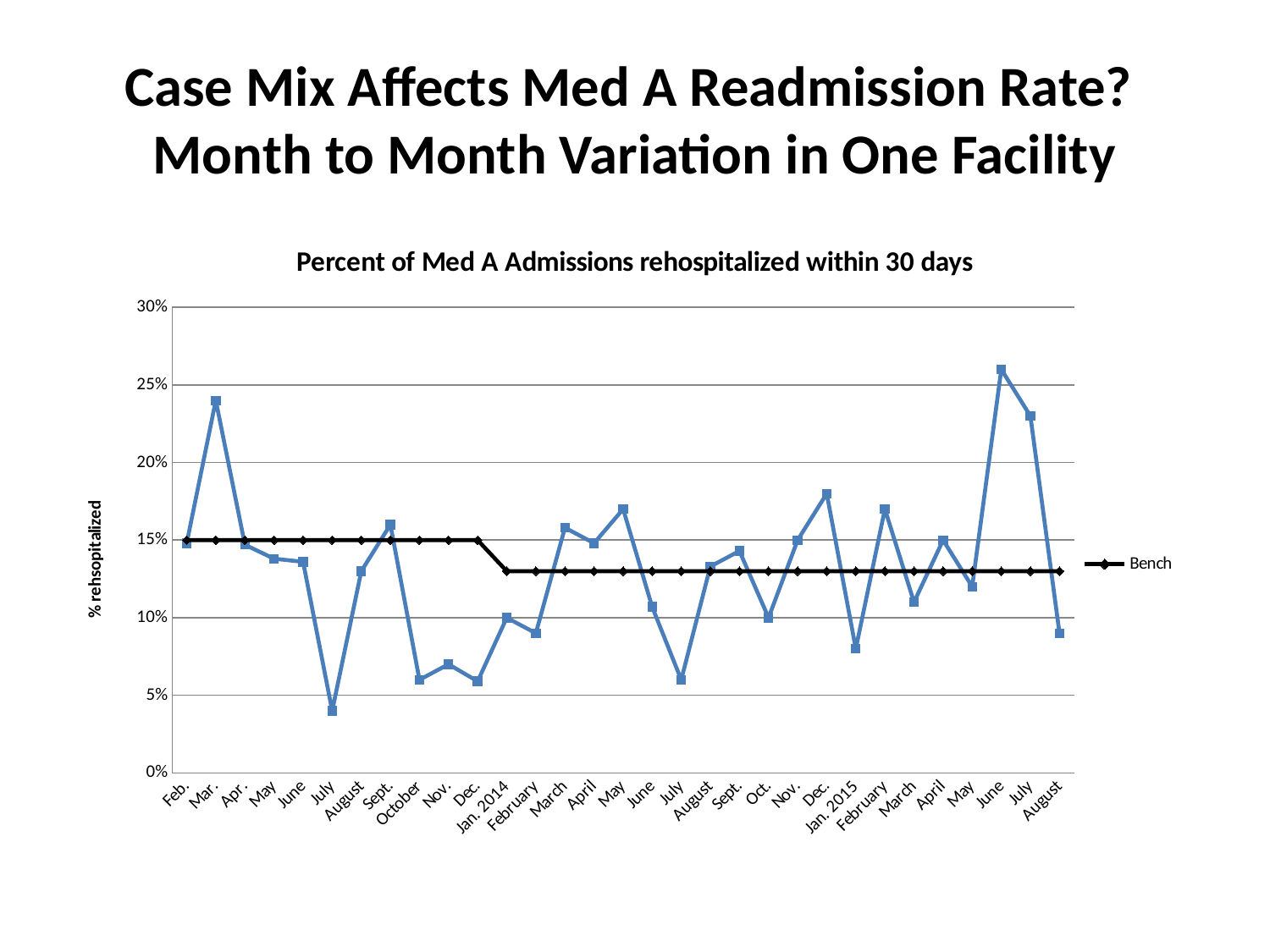
Which has the higher rehospitalization rate, Mar. (2013) or Dec. (2014)? Mar. (2013) What is the value of the Bench line for Feb. (the first month)? 15% Which month has the highest rehospitalization rate? June (2015) Does the Bench line rise or fall from Dec. 2013 to Jan. 2014? fall What kind of chart is shown on the slide? line chart What is the label on the vertical axis of the chart? % rehospitalized How many series does the chart's legend list? 1 Is the rehospitalization rate for June 2015 greater or less than 25%? greater Is the rehospitalization rate for the first July greater or less than 5%? less How many months (data points) are plotted along the x axis? 31 What is the title of the chart? Percent of Med A Admissions rehospitalized within 30 days Which month has the lowest rehospitalization rate? July (2013)